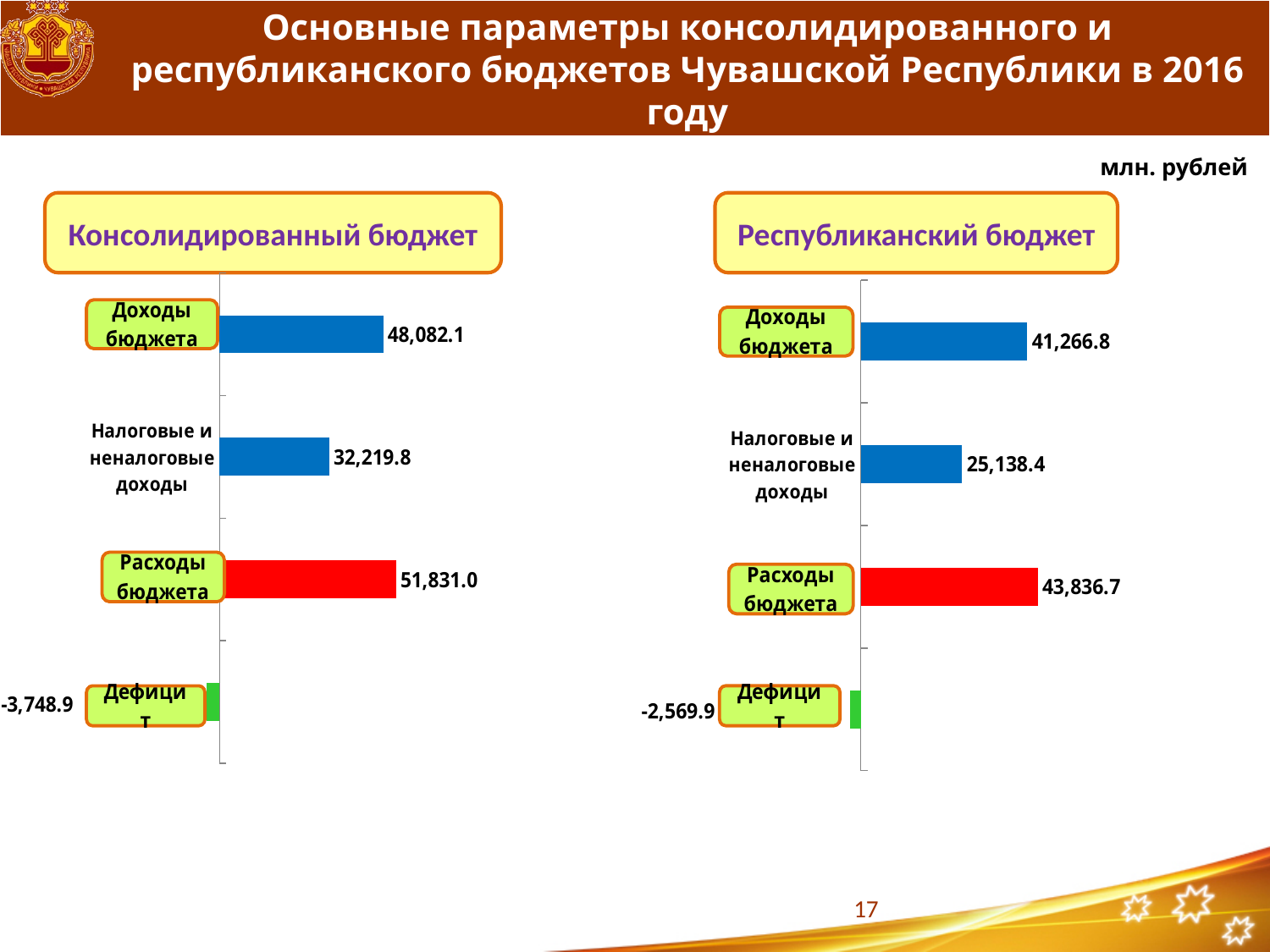
In the 'Консолидированный бюджет' chart, what is the difference between Расходы бюджета and Доходы бюджета? 3,748.9 In the 'Консолидированный бюджет' chart, what is the value for Расходы бюджета? 51,831.0 In the 'Консолидированный бюджет' chart, which category has the highest value? Расходы бюджета In the 'Республиканский бюджет' chart, what is the value for Дефицит? -2,569.9 In the 'Консолидированный бюджет' chart, what colour is the bar for Расходы бюджета? Red In the 'Республиканский бюджет' chart, which category has the lowest value? Дефицит In the 'Республиканский бюджет' chart, which is larger: Доходы бюджета or Расходы бюджета? Расходы бюджета What is the difference between Доходы бюджета in the 'Консолидированный бюджет' chart and Доходы бюджета in the 'Республиканский бюджет' chart? 6,815.3 How many categories are shown in the 'Консолидированный бюджет' chart? 4 In the 'Республиканский бюджет' chart, what is the value for Налоговые и неналоговые доходы? 25,138.4 In the 'Консолидированный бюджет' chart, what is the value for Доходы бюджета? 48,082.1 What type of chart is the 'Республиканский бюджет' chart? Bar chart